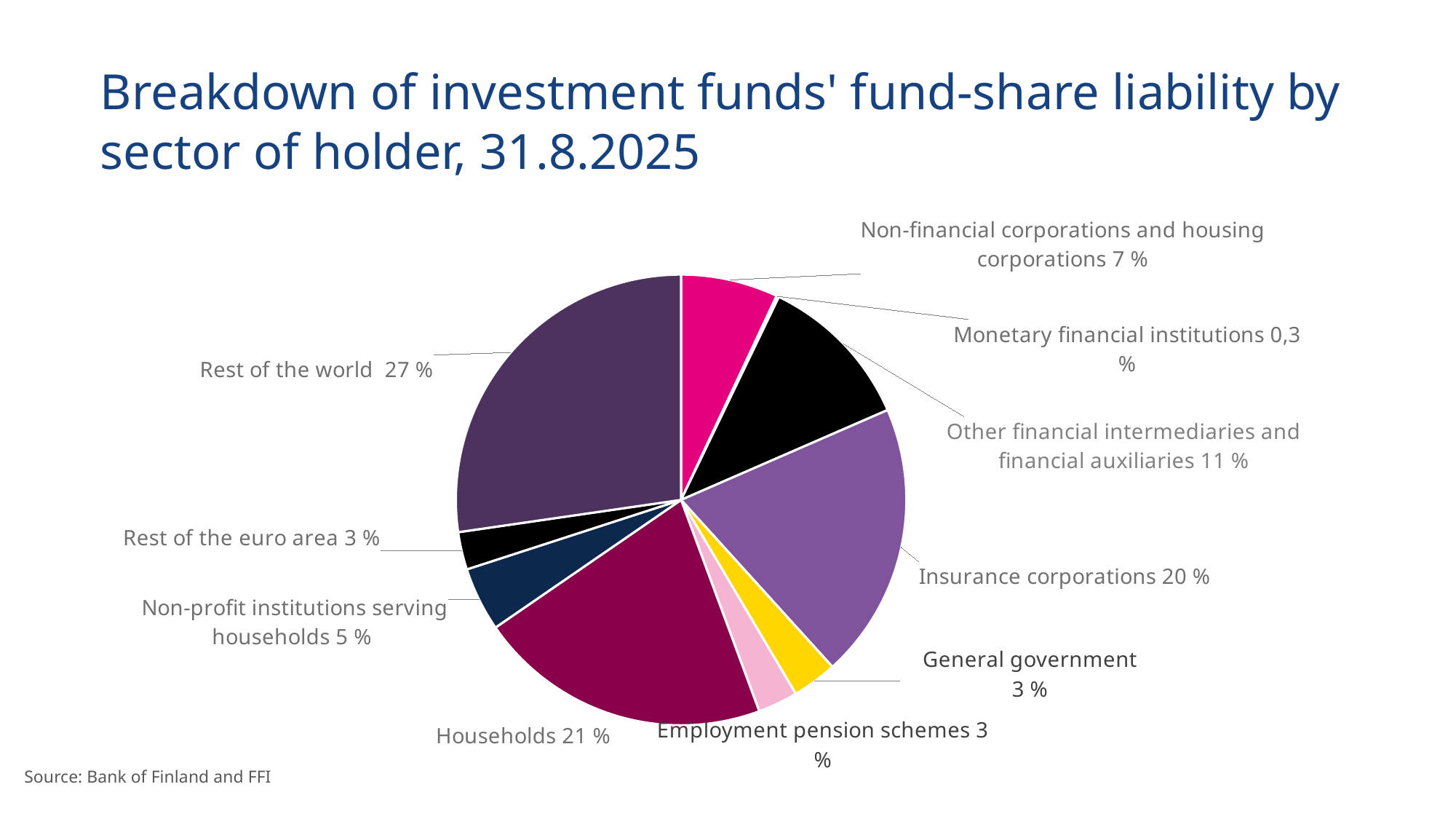
How many sectors are shown in the pie chart? 10 What is the difference in percentage points between Rest of the world and Households? 6 Which sector holds the smallest share of the pie? Monetary financial institutions What share of the pie does Rest of the world hold? 27 % What is the value shown for Insurance corporations? 20 % Which is larger, the share for Households or the share for Insurance corporations? Households Which sector holds the largest share of the pie? Rest of the world What kind of chart is shown on the slide? Pie chart What is the difference in percentage points between Insurance corporations and Other financial intermediaries and financial auxiliaries? 9 What is the value shown for Households? 21 % What is the value shown for Non-profit institutions serving households? 5 % What is the value shown for Monetary financial institutions? 0,3 %